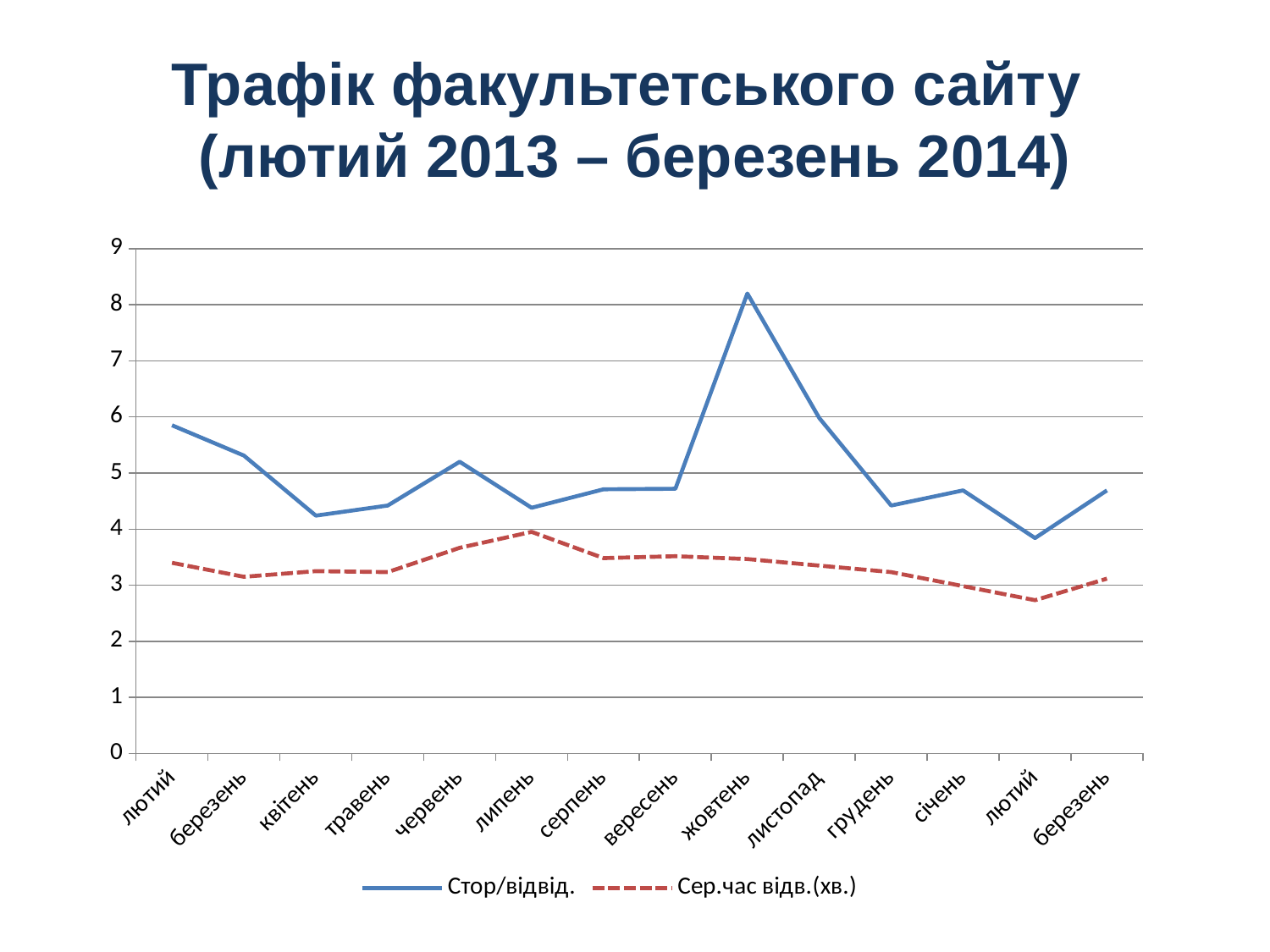
How many months are plotted along the x axis? 14 In which month does the Сер.час відв.(хв.) series reach its highest value? липень Is the Сер.час відв.(хв.) value for грудень greater or less than 4? less Is the Стор/відвід. value for жовтень greater or less than 7? greater In which month does the Стор/відвід. series reach its highest value? жовтень In which month does the Сер.час відв.(хв.) series reach its lowest value? лютий (2014, the second лютий) What is the title of the chart slide? Трафік факультетського сайту (лютий 2013 – березень 2014) What kind of chart is shown on the slide? line chart How many series does the legend list? 2 Is the Стор/відвід. value for квітень greater or less than 5? less In жовтень, which series has the larger value: Стор/відвід. or Сер.час відв.(хв.)? Стор/відвід. Does the Стор/відвід. series rise or fall from жовтень to грудень? fall